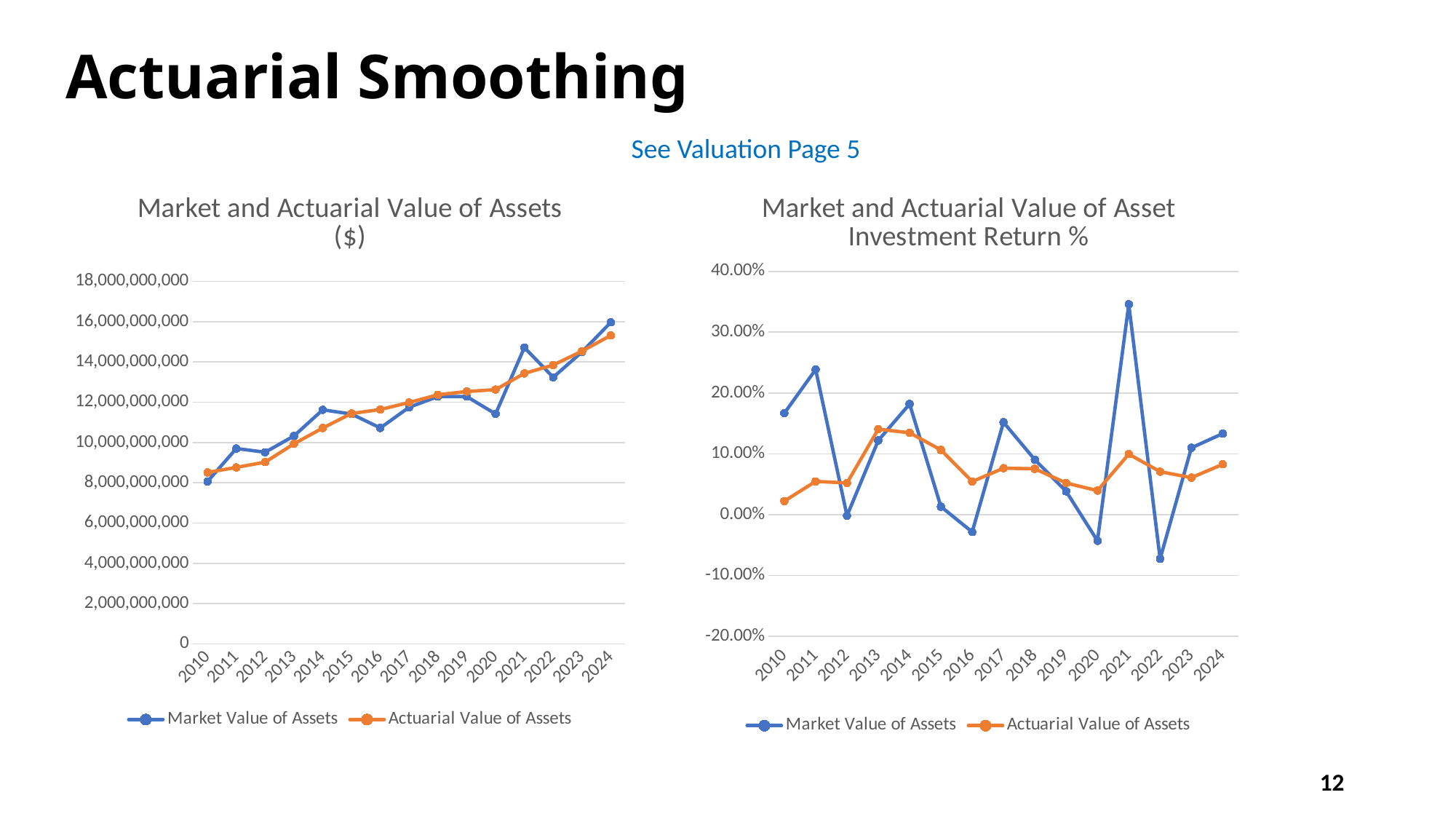
In the "Market and Actuarial Value of Asset Investment Return %" chart, which year has the highest Market Value of Assets return? 2021 In the "Market and Actuarial Value of Asset Investment Return %" chart, which series has the larger value in 2012, Market Value of Assets or Actuarial Value of Assets? Actuarial Value of Assets In the "Market and Actuarial Value of Asset Investment Return %" chart, is the Market Value of Assets return for 2021 greater or less than 30.00%? greater In the "Market and Actuarial Value of Assets ($)" chart, do the Actuarial Value of Assets values generally rise or fall from 2010 to 2024? rise In the "Market and Actuarial Value of Asset Investment Return %" chart, what colour is the Actuarial Value of Assets line? orange How many years are plotted on the x axis of the "Market and Actuarial Value of Assets ($)" chart? 15 In the "Market and Actuarial Value of Assets ($)" chart, which year has the highest Market Value of Assets? 2024 How many series does the legend of the "Market and Actuarial Value of Asset Investment Return %" chart list? 2 In the "Market and Actuarial Value of Asset Investment Return %" chart, which year has the lowest Market Value of Assets return? 2022 What kind of chart is the "Market and Actuarial Value of Assets ($)" chart? line chart In the "Market and Actuarial Value of Assets ($)" chart, which year has the lowest Market Value of Assets? 2010 In the "Market and Actuarial Value of Assets ($)" chart, is the Market Value of Assets for 2024 greater or less than 14,000,000,000? greater